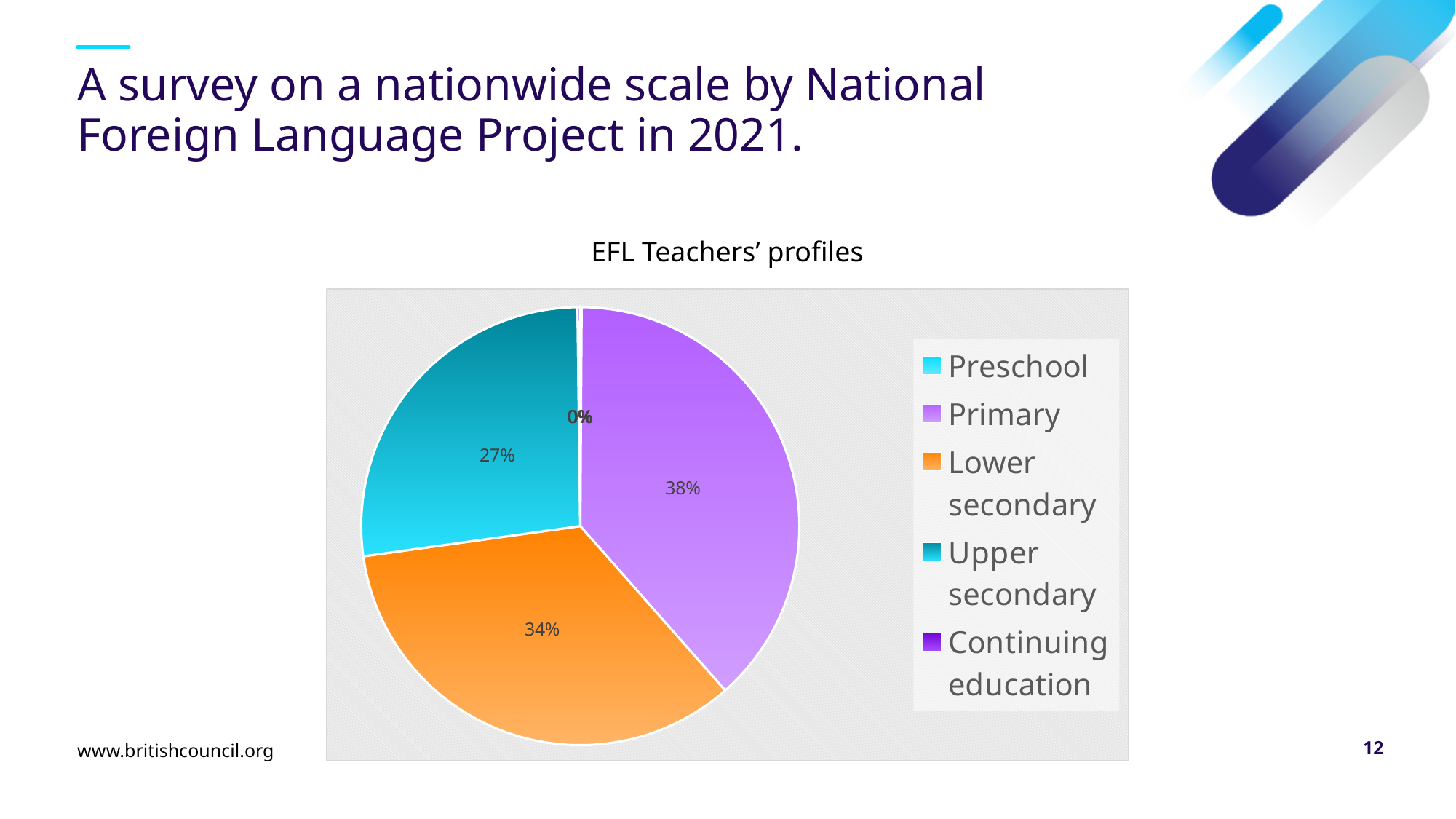
Which legend entry is listed last in the pie chart's legend? Continuing education What type of chart is shown on the slide? pie chart What share of the pie does Upper secondary represent? 27% What is the difference in percentage points between the Primary and Upper secondary slices? 11% How many categories does the legend of the pie chart list? 5 What is the title of the chart? EFL Teachers' profiles What is the difference in percentage points between the Lower secondary and Upper secondary slices? 7% What share of the pie does Lower secondary represent? 34% Which is larger, the Primary slice or the Lower secondary slice? Primary What share of the pie does Primary represent? 38% What percentage is shown for the Preschool slice? 0% Which category has the largest slice of the pie? Primary